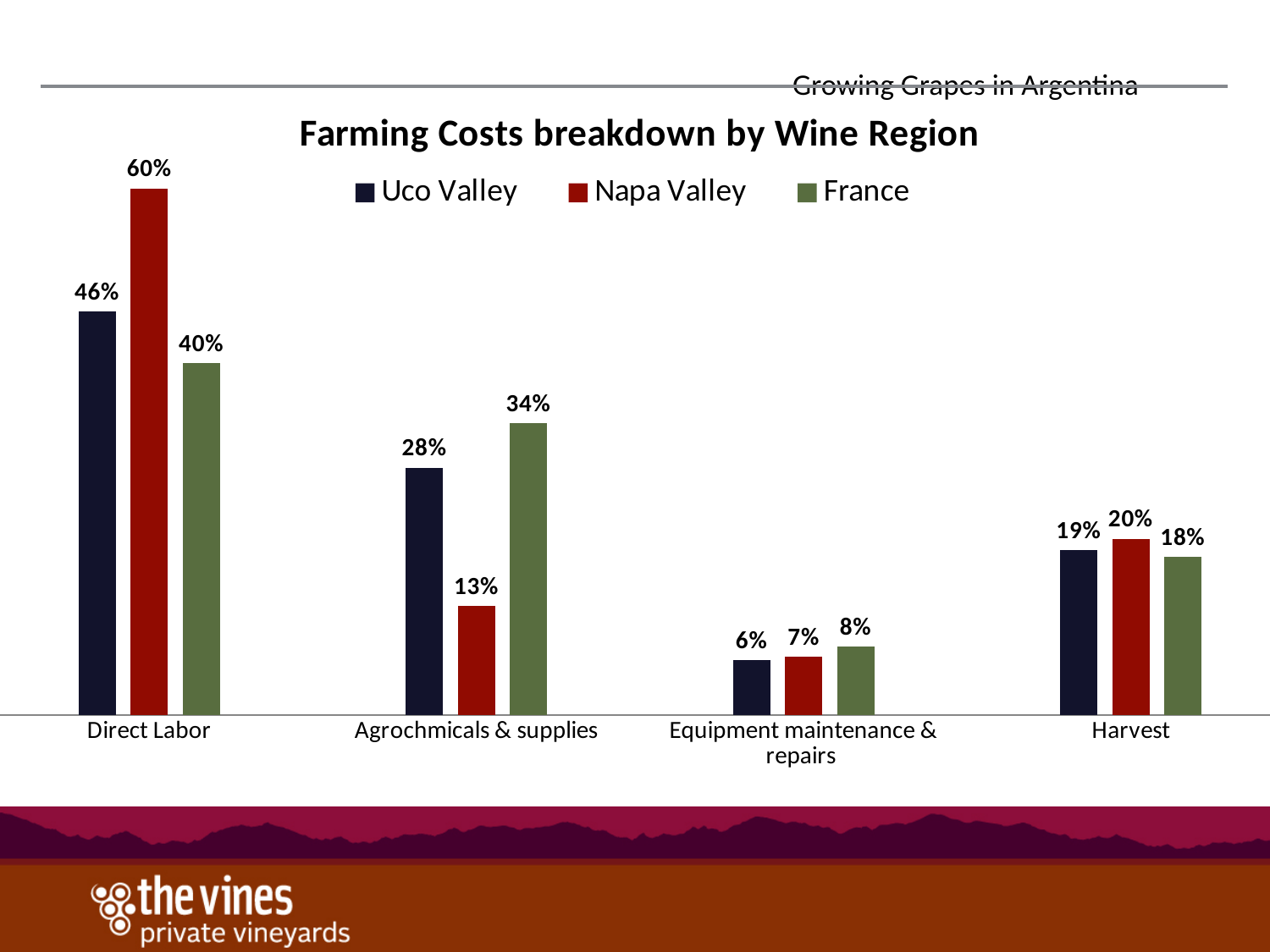
What is the title of the chart? Farming Costs breakdown by Wine Region How many series does the legend list? 3 What is the France value for Agrochmicals & supplies? 34% Which is larger for Agrochmicals & supplies: the Uco Valley value or the Napa Valley value? Uco Valley What kind of chart is shown on the slide? Bar chart Which category has the highest Uco Valley value? Direct Labor Which category has the lowest Napa Valley value? Equipment maintenance & repairs What is the Napa Valley value for Direct Labor? 60% What is the difference between the Napa Valley and Uco Valley values for Direct Labor? 14% How many categories are shown on the x axis? 4 What is the difference between the France and Napa Valley values for Agrochmicals & supplies? 21% What is the Uco Valley value for Harvest? 19%